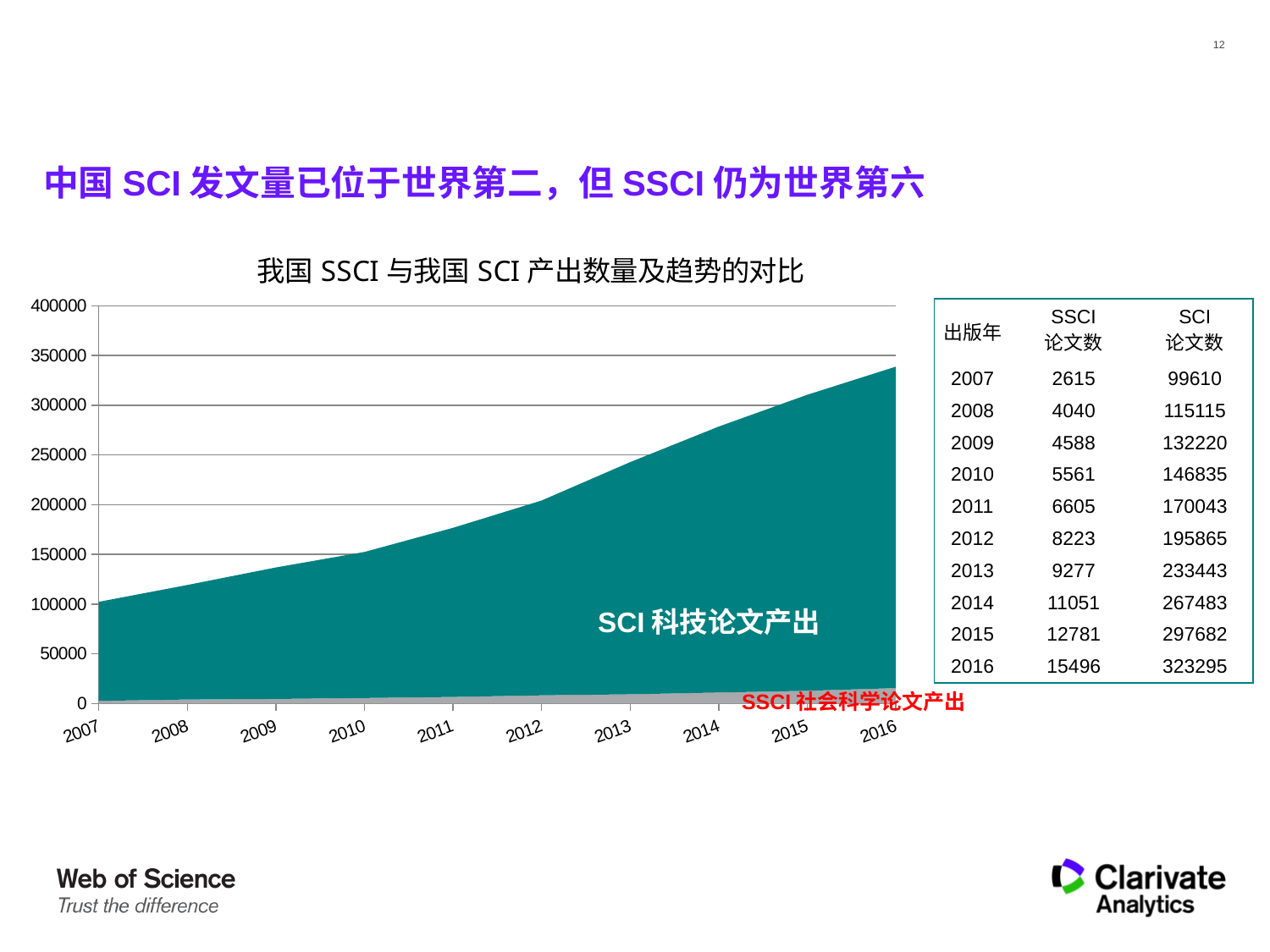
In which year is the SCI 论文数 highest? 2016 What kind of chart is shown on the slide? Area chart How many years are plotted along the x axis of the chart? 10 Does the SCI 科技论文产出 series rise or fall from 2007 to 2016? Rise In which year is the SSCI 论文数 lowest? 2007 What is the SSCI 论文数 value for 2007? 2615 What is the difference between the SCI 论文数 in 2016 and in 2007? 223685 What is the SCI 论文数 value for 2012? 195865 What is the SCI 论文数 value for 2016? 323295 Is the SCI value for 2013 greater or less than 200000? greater What is the title of the chart? 我国 SSCI 与我国 SCI 产出数量及趋势的对比 How many data series are plotted in the chart? 2